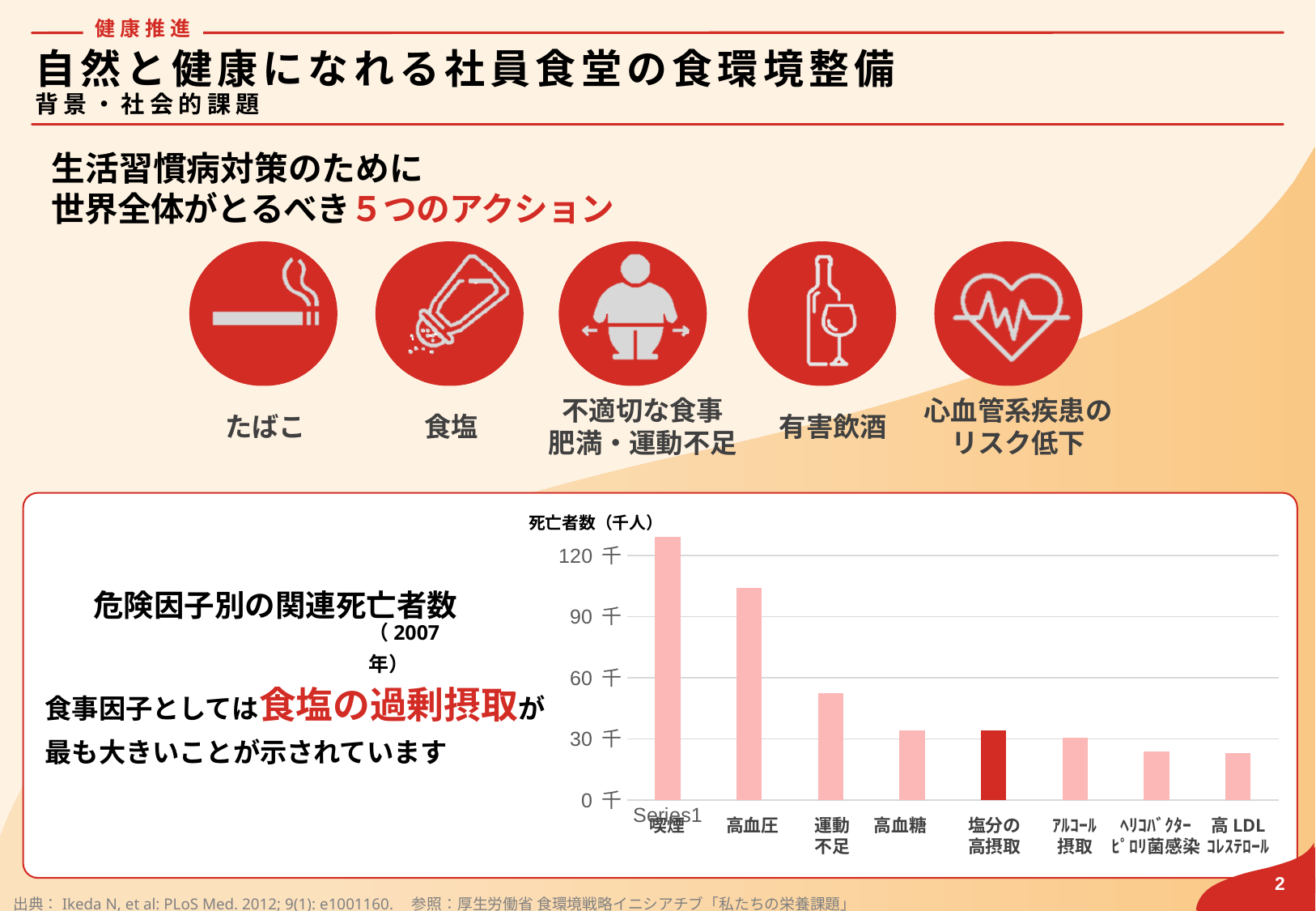
Which has more related deaths, 喫煙 or 高血圧? 喫煙 How many risk-factor categories are plotted in the bar chart? 8 Do the bar values generally rise or fall from left to right across the categories? fall Is the value for 高 LDL コレステロール greater or less than 30 千? less Which category's bar is highlighted in a darker red than the others? 塩分の高摂取 Is the value for 運動不足 greater or less than 60 千? less Which has more related deaths, 運動不足 or 高血糖? 運動不足 Is the value for 高血圧 greater or less than 90 千? greater What kind of chart is shown on the slide? bar chart Which risk factor has the highest number of related deaths in the chart? 喫煙